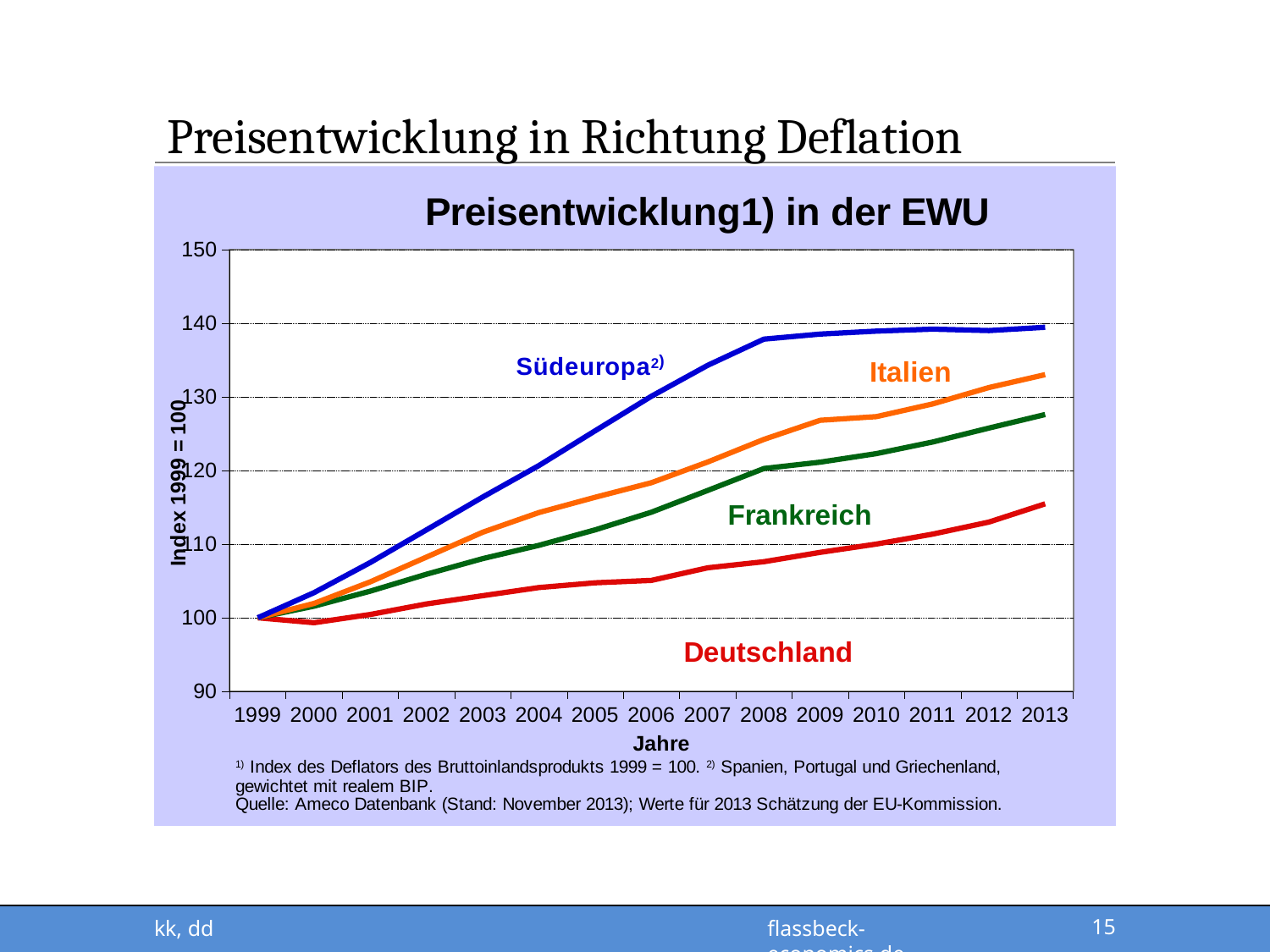
How many years are shown on the x axis of the chart? 15 Does the Italien series rise or fall from 1999 to 2013? rise Is the value for Frankreich in 2013 greater or less than 120? greater What is the title of the chart? Preisentwicklung1) in der EWU What is the value of the Deutschland series in 1999? 100 Is the value for Deutschland in 2006 greater or less than 110? less How many series (lines) are plotted in the chart? 4 Which series has the larger value in 2010, Italien or Frankreich? Italien What kind of chart is shown on the slide? line chart Which series has the highest value in 2013? Südeuropa Which series has the lowest value in 2013? Deutschland Is the value for Südeuropa in 2008 greater or less than 130? greater